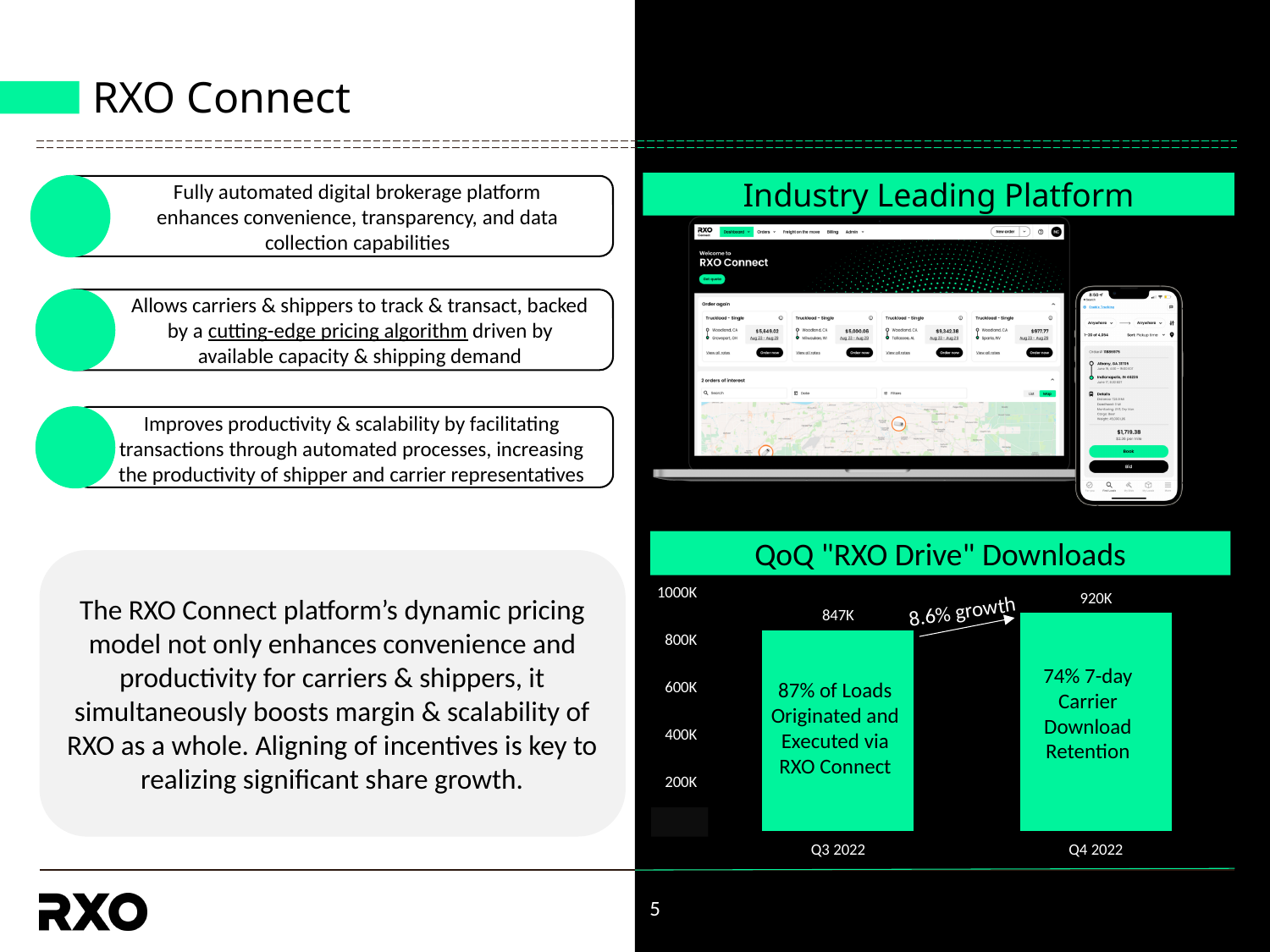
What is the difference between the Q4 2022 and Q3 2022 values in the QoQ "RXO Drive" Downloads chart? 73K Do the values rise or fall from Q3 2022 to Q4 2022 in the QoQ "RXO Drive" Downloads chart? rise What is the value for Q4 2022 in the QoQ "RXO Drive" Downloads chart? 920K What growth percentage is annotated between the two bars in the QoQ "RXO Drive" Downloads chart? 8.6% growth What kind of chart is the QoQ "RXO Drive" Downloads chart? bar chart In the QoQ "RXO Drive" Downloads chart, is the value for Q3 2022 larger or smaller than the value for Q4 2022? smaller Is the value for Q3 2022 in the QoQ "RXO Drive" Downloads chart greater or less than 800K? greater How many quarters are shown in the QoQ "RXO Drive" Downloads chart? 2 Is the value for Q4 2022 in the QoQ "RXO Drive" Downloads chart greater or less than 1000K? less Which quarter has the higher number of downloads in the QoQ "RXO Drive" Downloads chart? Q4 2022 Which quarter has the lower number of downloads in the QoQ "RXO Drive" Downloads chart? Q3 2022 What is the value for Q3 2022 in the QoQ "RXO Drive" Downloads chart? 847K